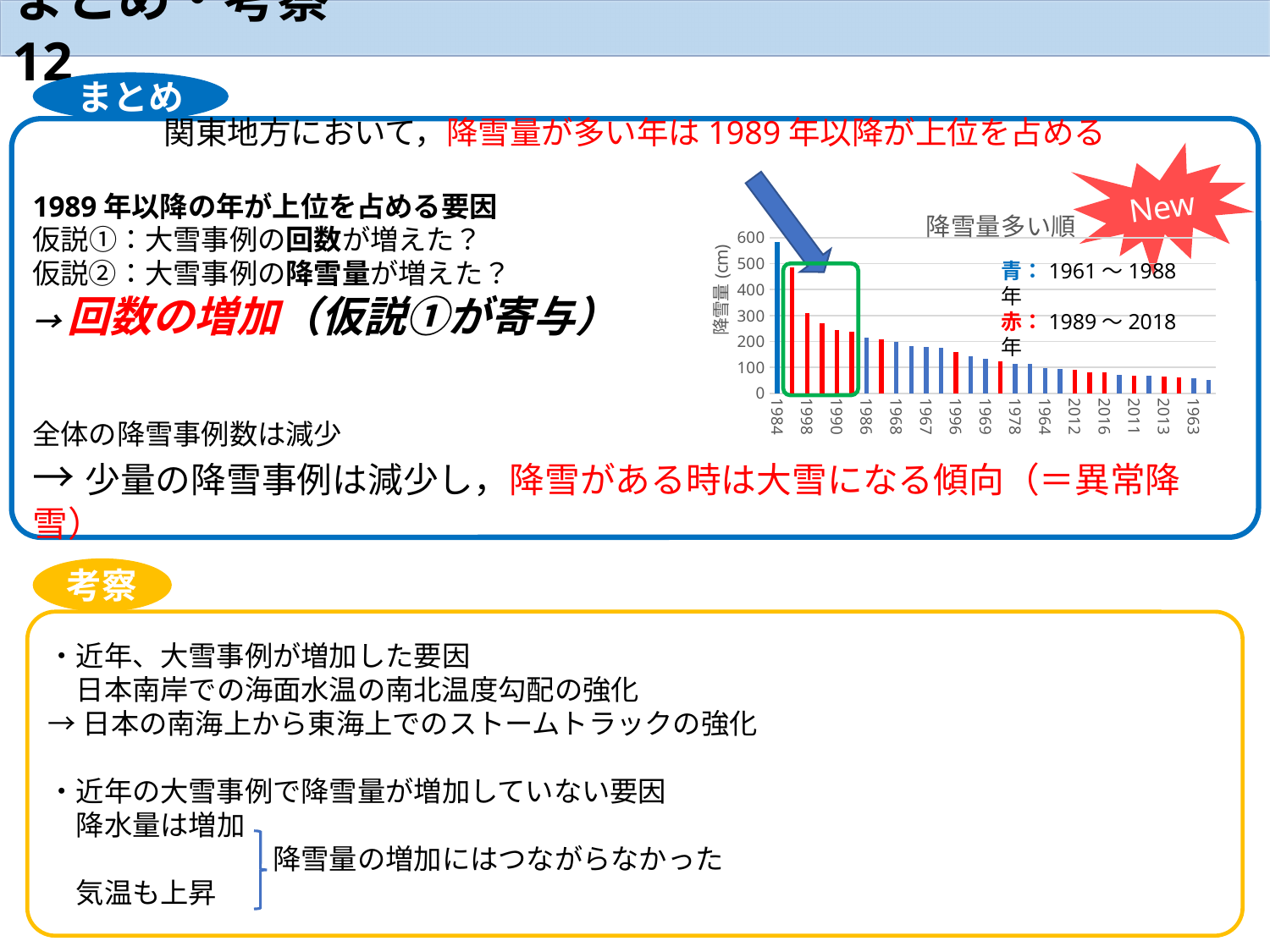
What is the label of the y axis of the chart? 降雪量 (cm) Do the bar values rise or fall from left to right along the x axis? fall According to the chart's legend, which colour represents the years 1989～2018? 赤 (red) Which year has the highest snowfall in the chart? 1984 Which has the larger snowfall value, 1998 or 1963? 1998 Which has the larger snowfall value, 1984 or 1998? 1984 Is the value for 1963 greater or less than 100? less Is the value for 1984 greater or less than 500? greater What is the title of the chart on the slide? 降雪量多い順 Is the value for 1990 greater or less than 300? less What kind of chart is shown on the slide? bar chart